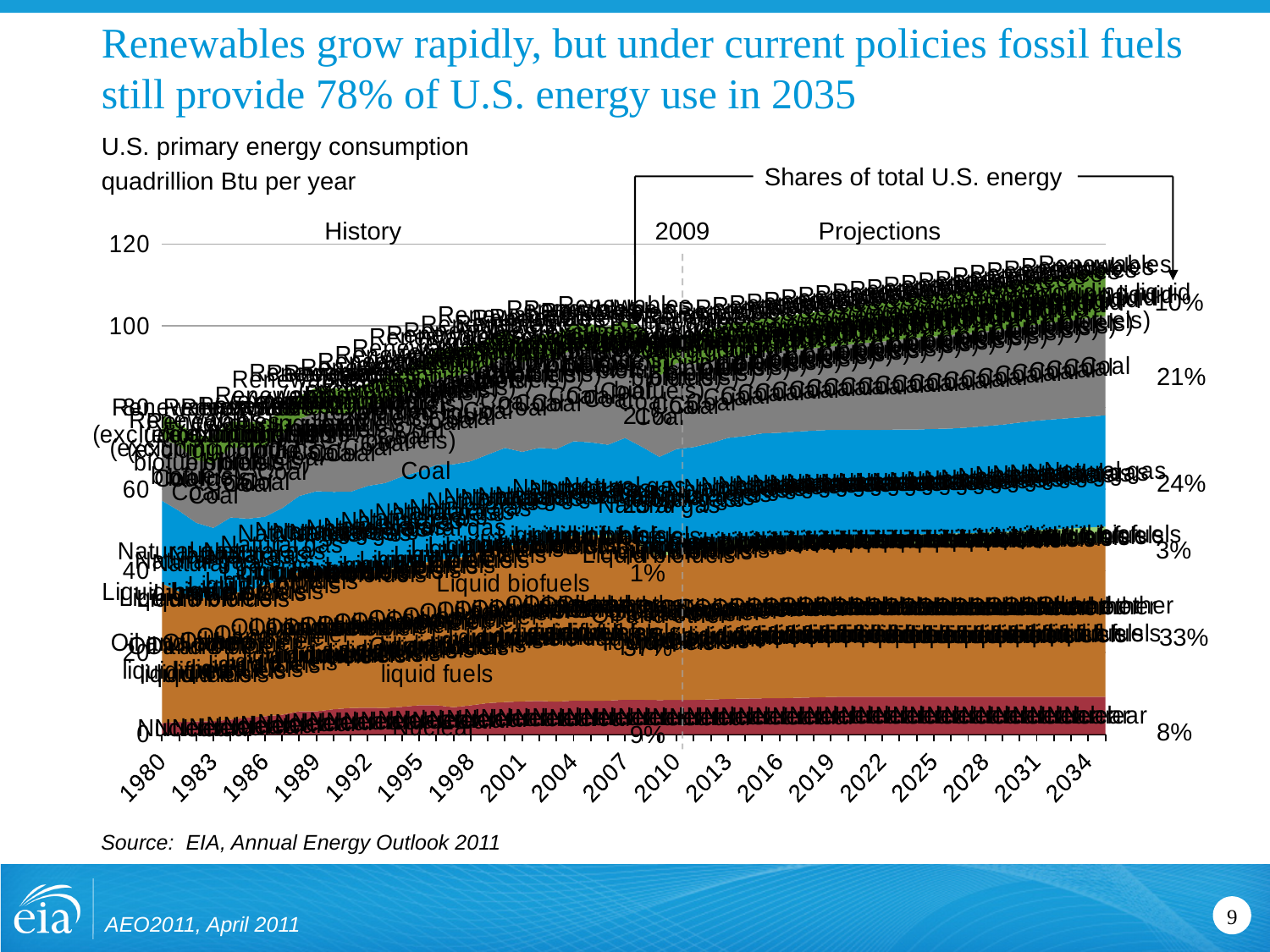
What share of total U.S. energy does coal provide in 2035 according to the projections? 21% What kind of chart is shown on the slide? Stacked area chart What share of total U.S. energy does nuclear provide in 2035? 8% What share of total U.S. energy do renewables provide in 2035? 10% In what units is U.S. primary energy consumption measured on the chart? Quadrillion Btu per year Is total U.S. primary energy consumption in 2035 greater or less than 100 quadrillion Btu? greater Which energy source has the largest share of total U.S. energy in 2035? Oil and other liquid fuels By how many percentage points does the 2035 share of natural gas exceed the 2035 share of coal? 3 percentage points Which energy source has the smallest share of total U.S. energy in 2035? Liquid biofuels